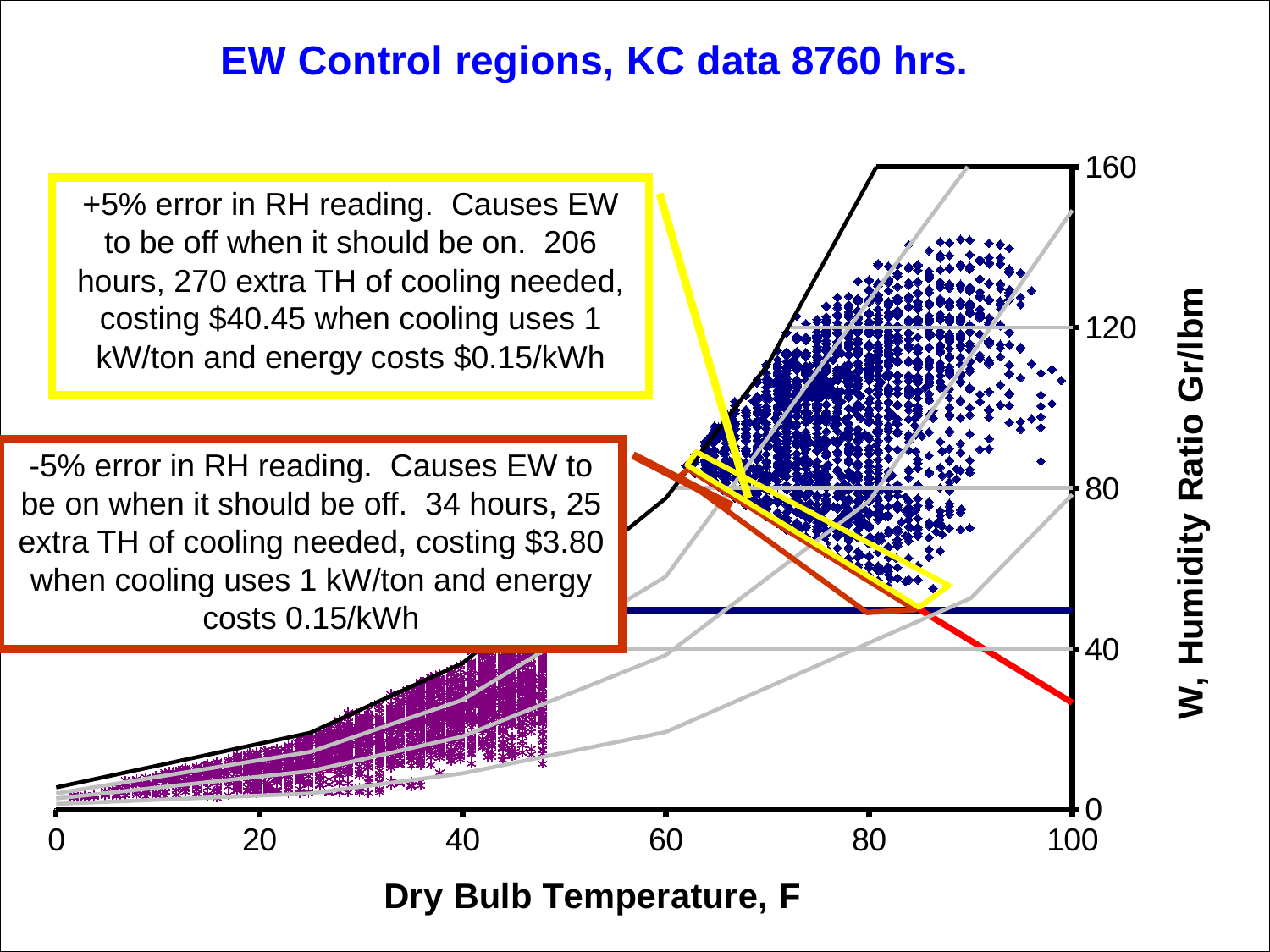
Does the red line rise or fall as dry bulb temperature increases from 80 to 100 F? Fall Which group of data points reaches higher humidity ratios, the blue diamonds or the purple points? Blue diamonds What is the highest value shown on the y axis? 160 Is the humidity ratio of the horizontal dark blue line greater or less than 40? greater What is the highest value shown on the x axis? 100 Are the purple data points at dry bulb temperatures greater or less than 60 F? less What is the title of the chart? EW Control regions, KC data 8760 hrs. Is the humidity ratio of the horizontal dark blue line greater or less than 80? less What is the label of the x axis? Dry Bulb Temperature, F What kind of chart is shown on the slide? Scatter chart